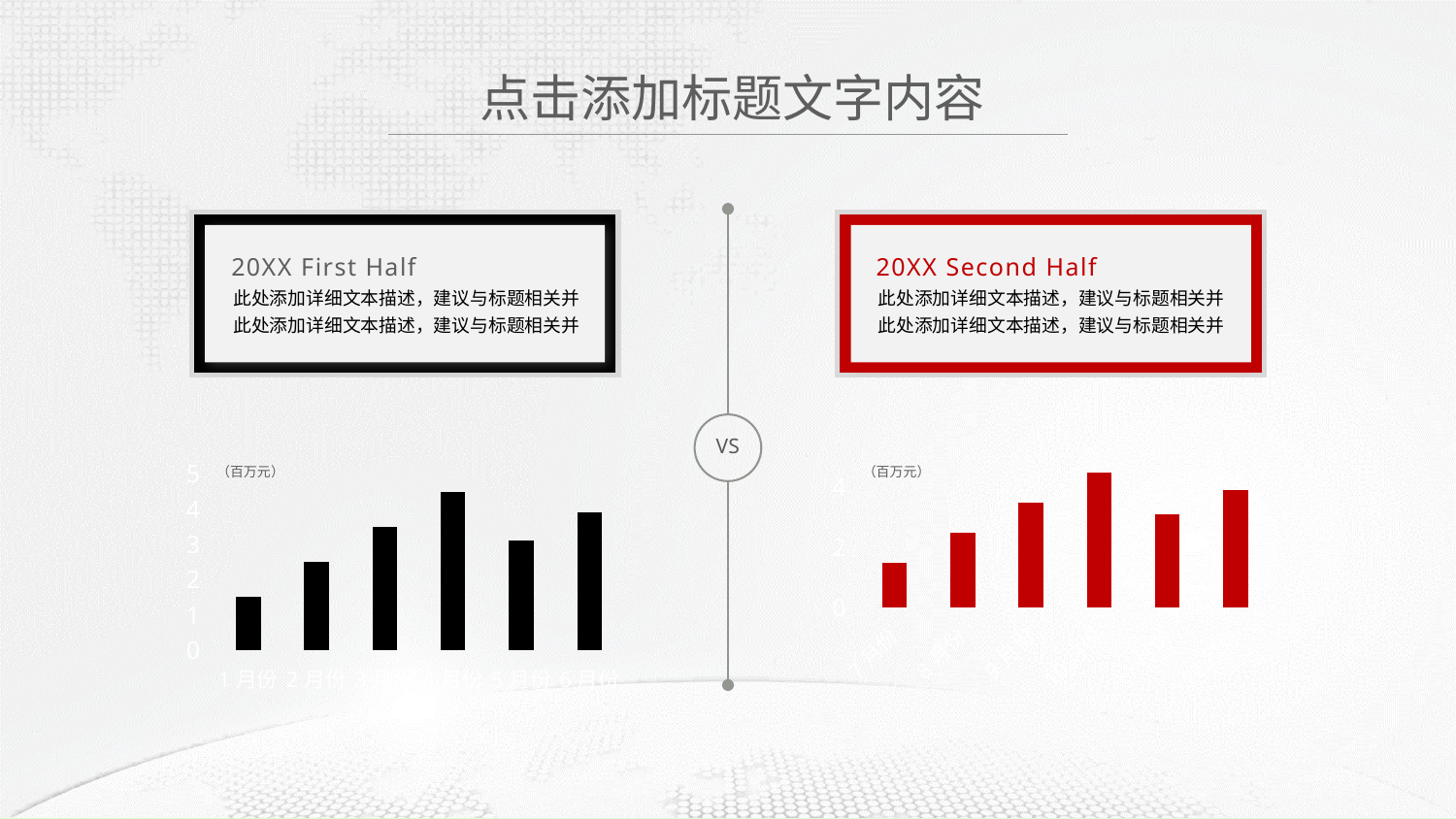
What kind of chart is shown on the left side of the slide under '20XX First Half'? bar chart In the right chart (20XX Second Half), which bar is the tallest, counting from the left? the fourth bar In the left chart (20XX First Half), is the value for 4 月份 greater or less than 4? greater In the right chart (20XX Second Half), is the value of the first bar greater or less than 2? less In the left chart (20XX First Half), which is larger, the bar for 4 月份 or the bar for 5 月份? 4 月份 In the right chart (20XX Second Half), is the value of the tallest bar greater or less than 4? greater In the left chart (20XX First Half), which month has the lowest bar? 1 月份 How many bars does the right chart (20XX Second Half) have? 6 In the left chart (20XX First Half), which month has the highest bar? 4 月份 How many bars does the left chart (20XX First Half) have? 6 What unit is shown at the top of the y axis of both charts? 百万元